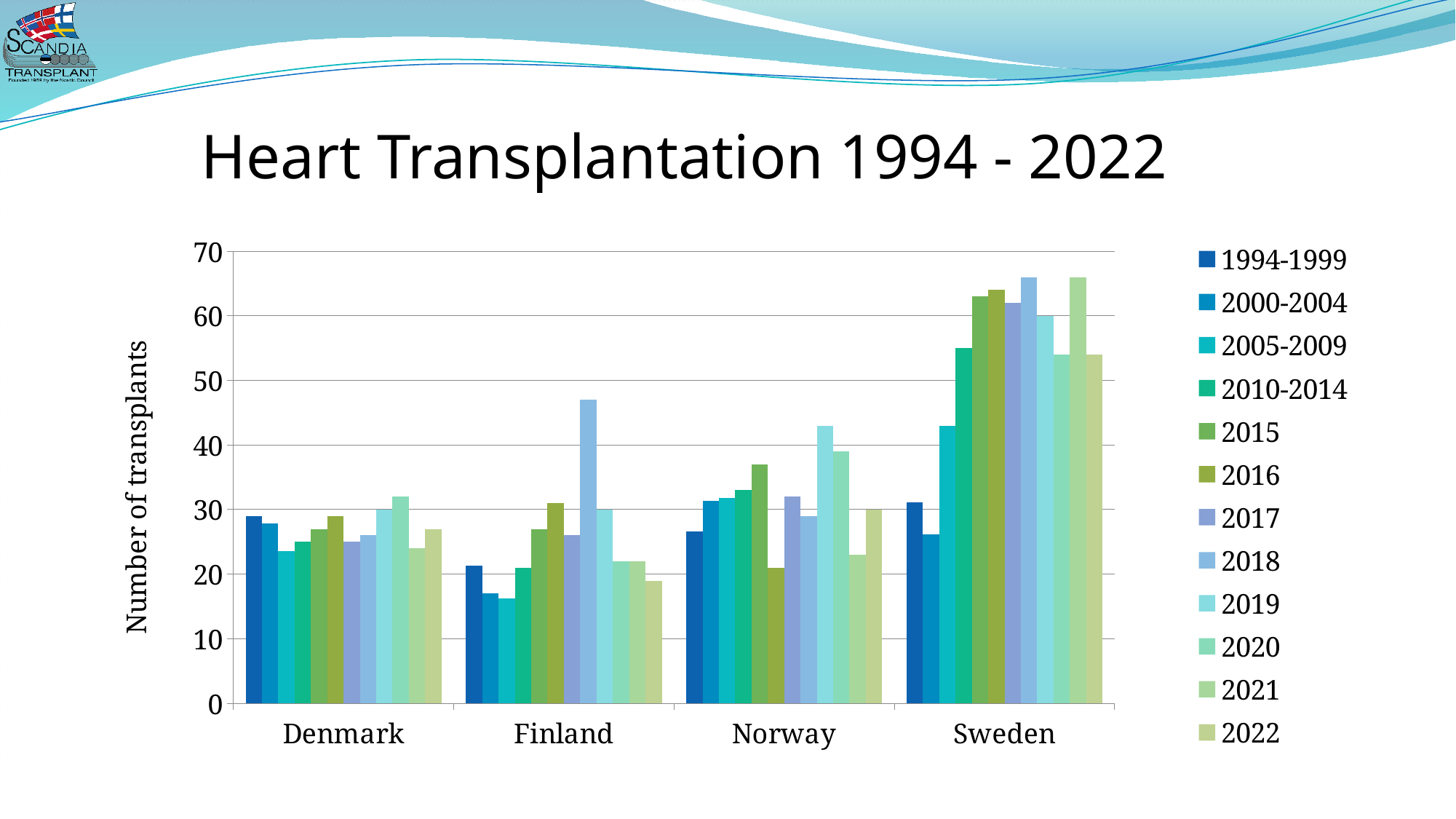
Which is larger, the 2015 value for Sweden or the 2015 value for Denmark? Sweden Which is larger, the 2018 value for Finland or the 2018 value for Norway? Finland What kind of chart is shown on the slide? bar chart For Sweden, which series has the lowest bar? 2000-2004 Is the value for Finland in 2018 greater or less than 40? greater Which country has the tallest bar in the chart? Sweden Is the value for Finland in 2005-2009 greater or less than 20? less What is the label on the vertical axis of the chart? Number of transplants How many series does the legend list? 12 Is the value for Sweden in 2016 greater or less than 60? greater How many countries are shown on the x axis of the chart? 4